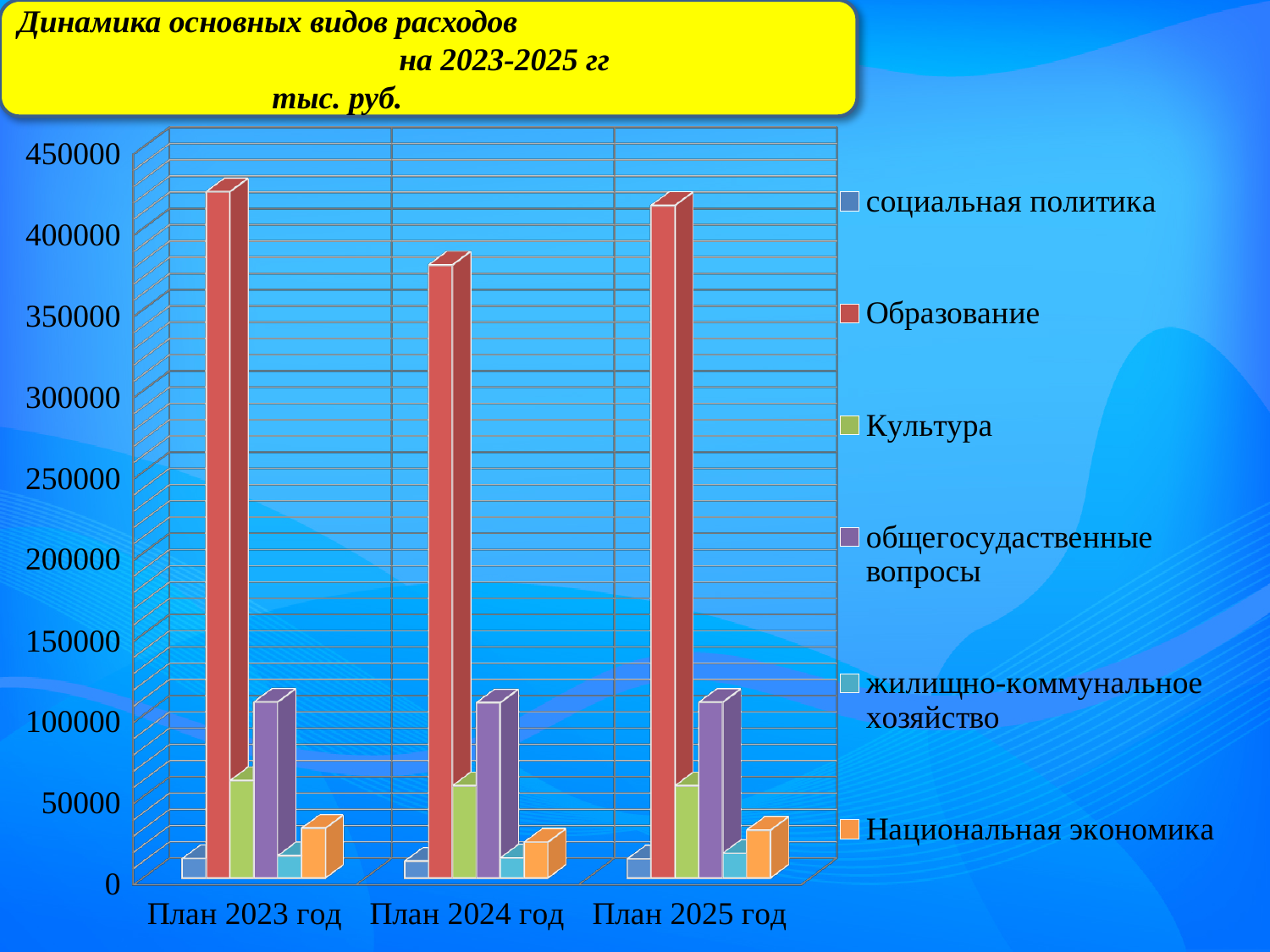
How many series does the legend list? 6 Which is larger in План 2024 год: Культура or Национальная экономика? Культура How many categories (years) are shown on the x axis? 3 In which year is the value for Образование the lowest? План 2024 год Which series has the highest value in План 2023 год? Образование Is the value for Образование in План 2024 год greater or less than 400000? less Is the value for Культура in План 2023 год greater or less than 100000? less What colour are the bars for Образование? red Is the value for Образование in План 2023 год greater or less than 400000? greater What kind of chart is shown on the slide? bar chart Which is larger: Образование in План 2025 год or Образование in План 2024 год? Образование in План 2025 год